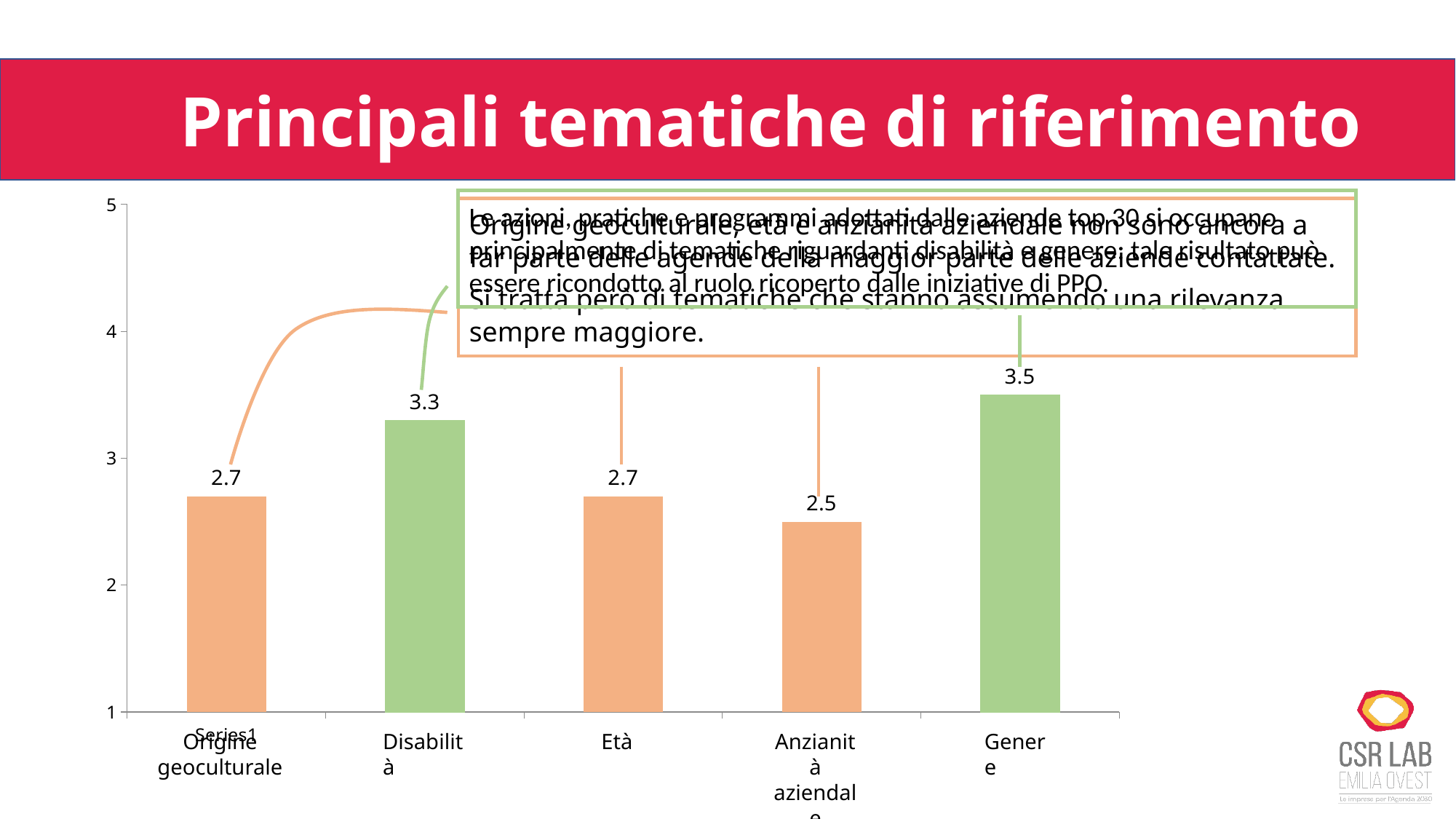
What is the value for Disabilità? 3.3 Which is larger, the value for Disabilità or the value for Età? Disabilità How many categories are shown in the chart? 5 What colour are the bars for Disabilità and Genere? Green What is the difference between the values for Genere and Anzianità aziendale? 1.0 Which category has the highest value? Genere What is the value for Origine geoculturale? 2.7 What is the value for Anzianità aziendale? 2.5 What is the difference between the values for Disabilità and Età? 0.6 Which category has the lowest value? Anzianità aziendale What kind of chart is shown on the slide? Bar chart What is the value for Genere? 3.5